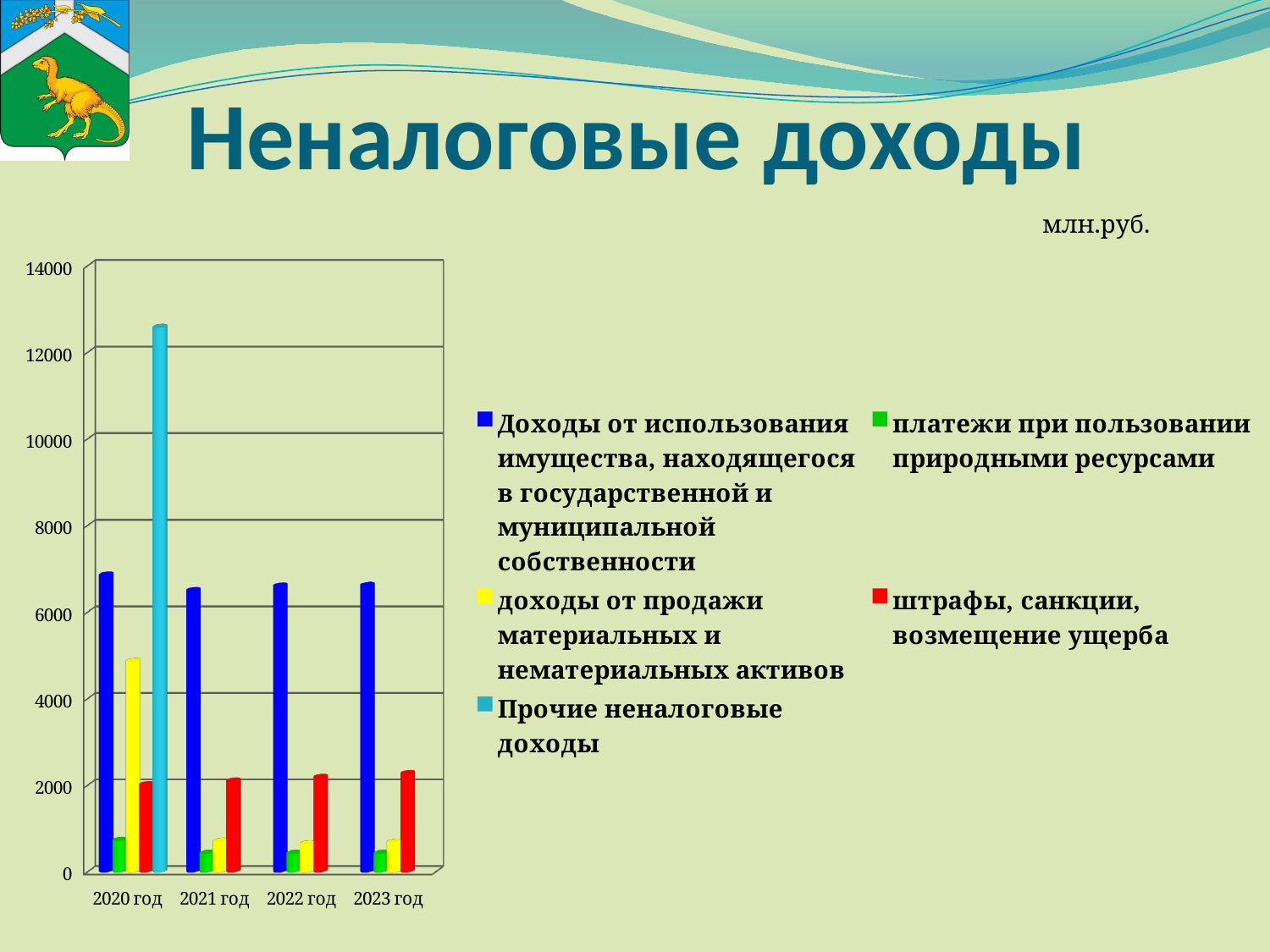
Is the value for платежи при пользовании природными ресурсами in 2020 год greater or less than 2000? less Is the value for Прочие неналоговые доходы in 2020 год greater or less than 12000? greater How many years (categories) are shown on the x axis of the chart? 4 Is the value for Доходы от использования имущества in 2020 год greater or less than 6000? greater In which year does the tallest bar on the chart appear? 2020 год Which colour represents штрафы, санкции, возмещение ущерба in the chart legend? red In 2020 год, which is larger: доходы от продажи материальных и нематериальных активов or штрафы, санкции, возмещение ущерба? доходы от продажи материальных и нематериальных активов Which series has the highest value in 2020 год? Прочие неналоговые доходы What kind of chart is shown on the slide? bar chart How many series does the chart legend list? 5